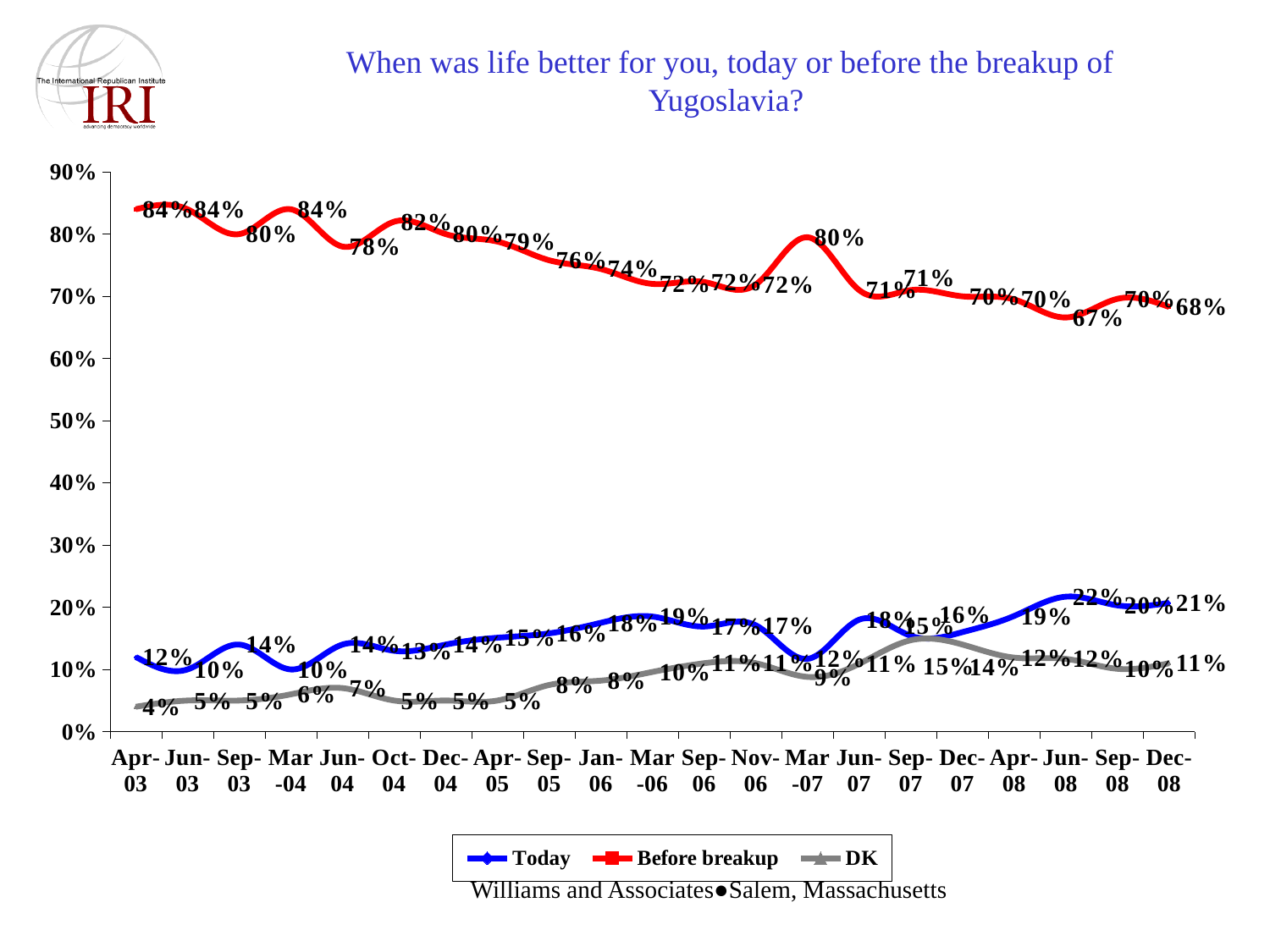
What is the value for 'DK' in Sep-07? 15% What kind of chart is shown on the slide? Line chart What is the value for 'Before breakup' in Apr-03? 84% In which survey period does the 'Before breakup' series reach its lowest value? Jun-08 Does the 'Before breakup' series generally rise or fall from Apr-03 to Dec-08? Fall In Mar-07, which is larger, the 'Today' value or the 'DK' value? Today How many series does the legend list? 3 What are the three series named in the legend? Today, Before breakup, DK What is the value for 'Today' in Dec-08? 21% In which survey period does the 'Today' series reach its highest value? Jun-08 What is the value for 'Before breakup' in Mar-07? 80% In Dec-08, what is the difference between the 'Before breakup' value and the 'Today' value? 47 percentage points